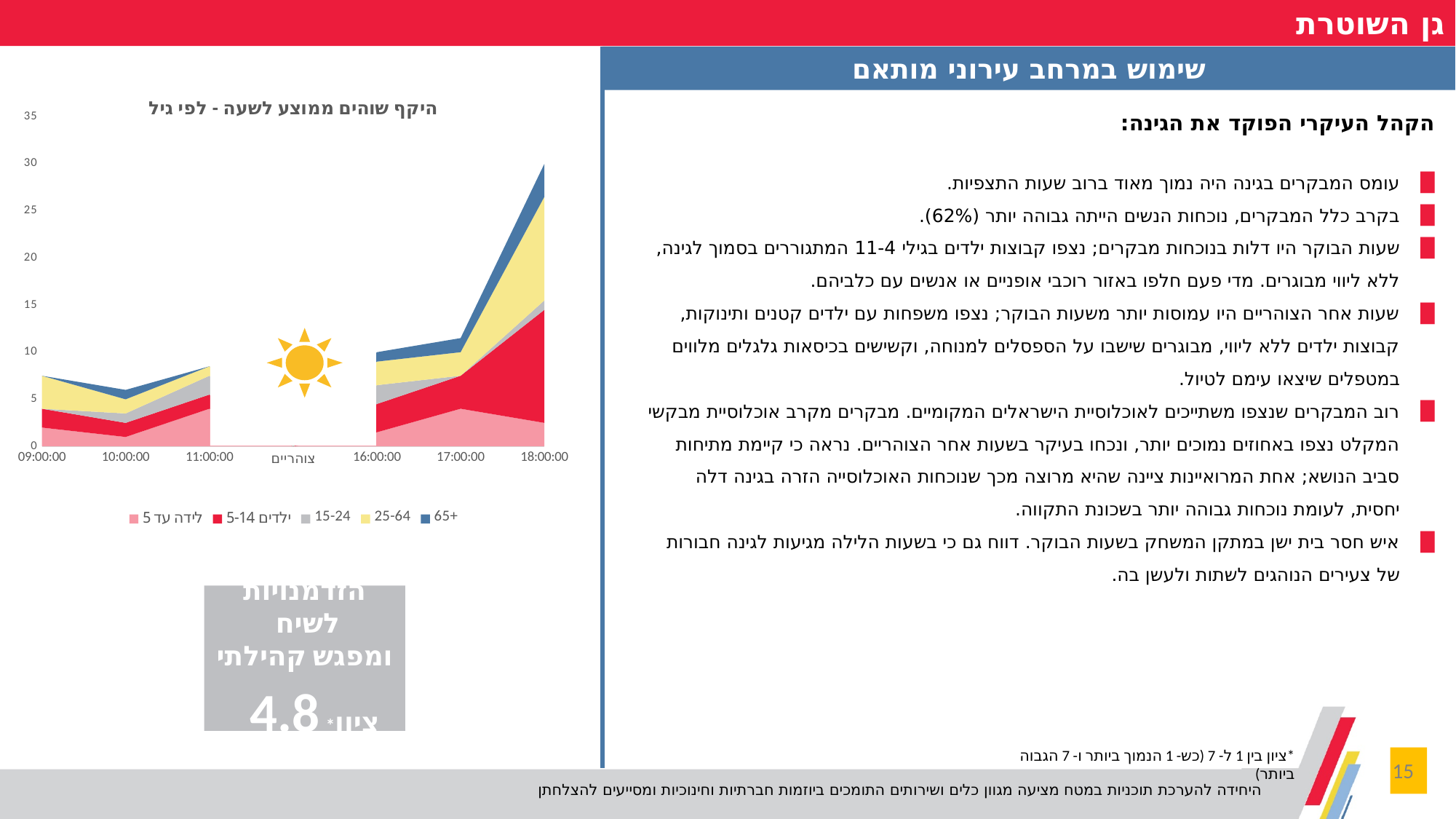
How many series does the chart legend list? 5 Is the stacked total at 09:00:00 greater or less than 10? less Is the stacked total at 16:00:00 greater or less than 15? less What kind of chart is shown on the slide? area chart Is the stacked total at 18:00:00 greater or less than 25? greater How many categories are labelled along the x axis of the chart? 7 What is the title of the chart? היקף שוהים ממוצע לשעה - לפי גיל Do the stacked totals rise or fall from 16:00:00 to 18:00:00? rise Which colour represents the 65+ series in the legend? blue Is the stacked total at 18:00:00 larger or smaller than at 17:00:00? larger At which time does the stacked total reach its highest value? 18:00:00